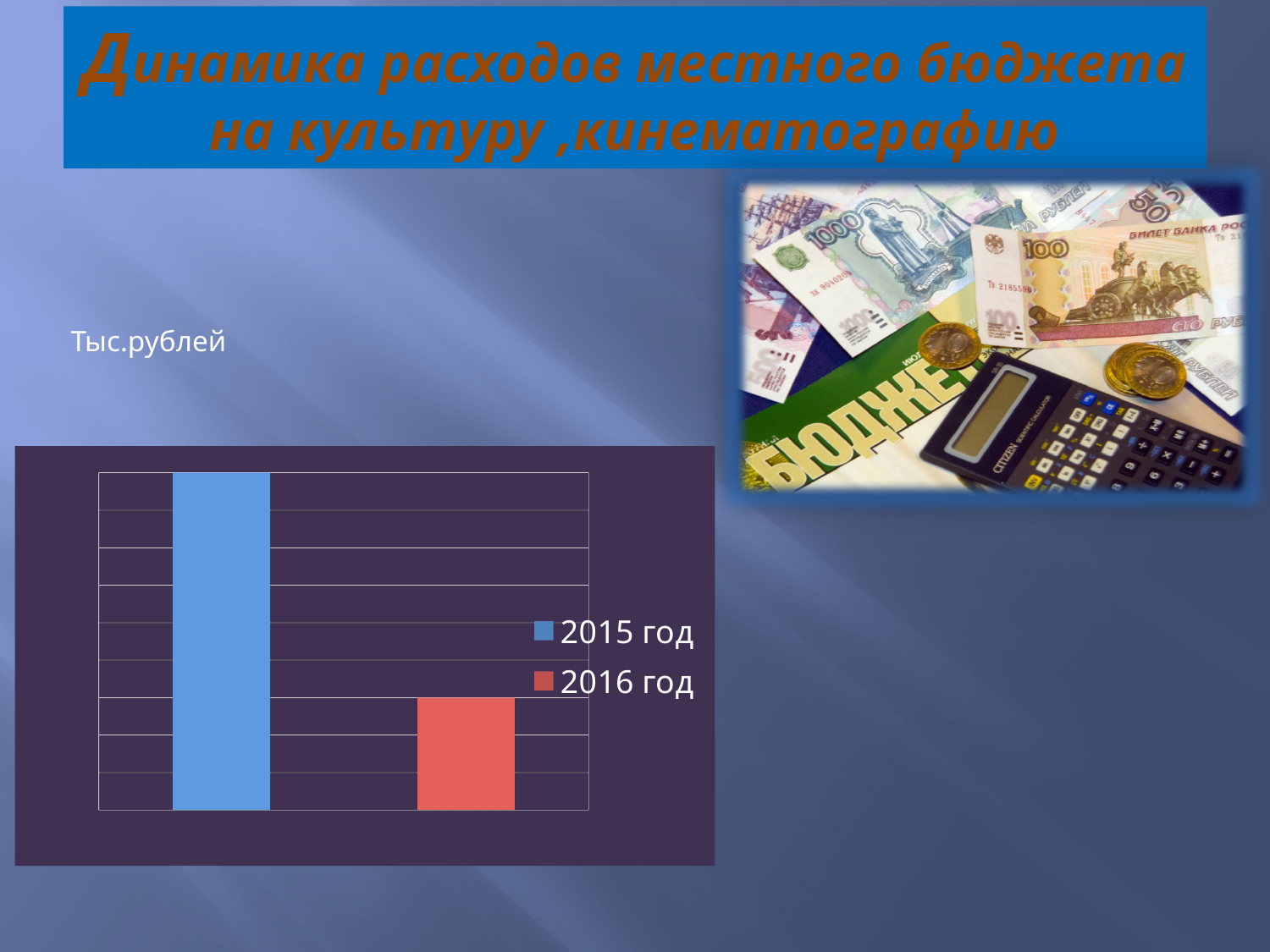
Which year has the taller bar, 2015 год or 2016 год? 2015 год Which legend entry has the highest value in the chart? 2015 год Which legend entry has the lowest value in the chart? 2016 год What colour is the bar for 2016 год? red How many entries does the chart legend list? 2 What kind of chart is shown on the slide? bar chart What unit is stated above the chart? Тыс.рублей Do the values rise or fall from 2015 год to 2016 год? fall How many bars are plotted in the chart? 2